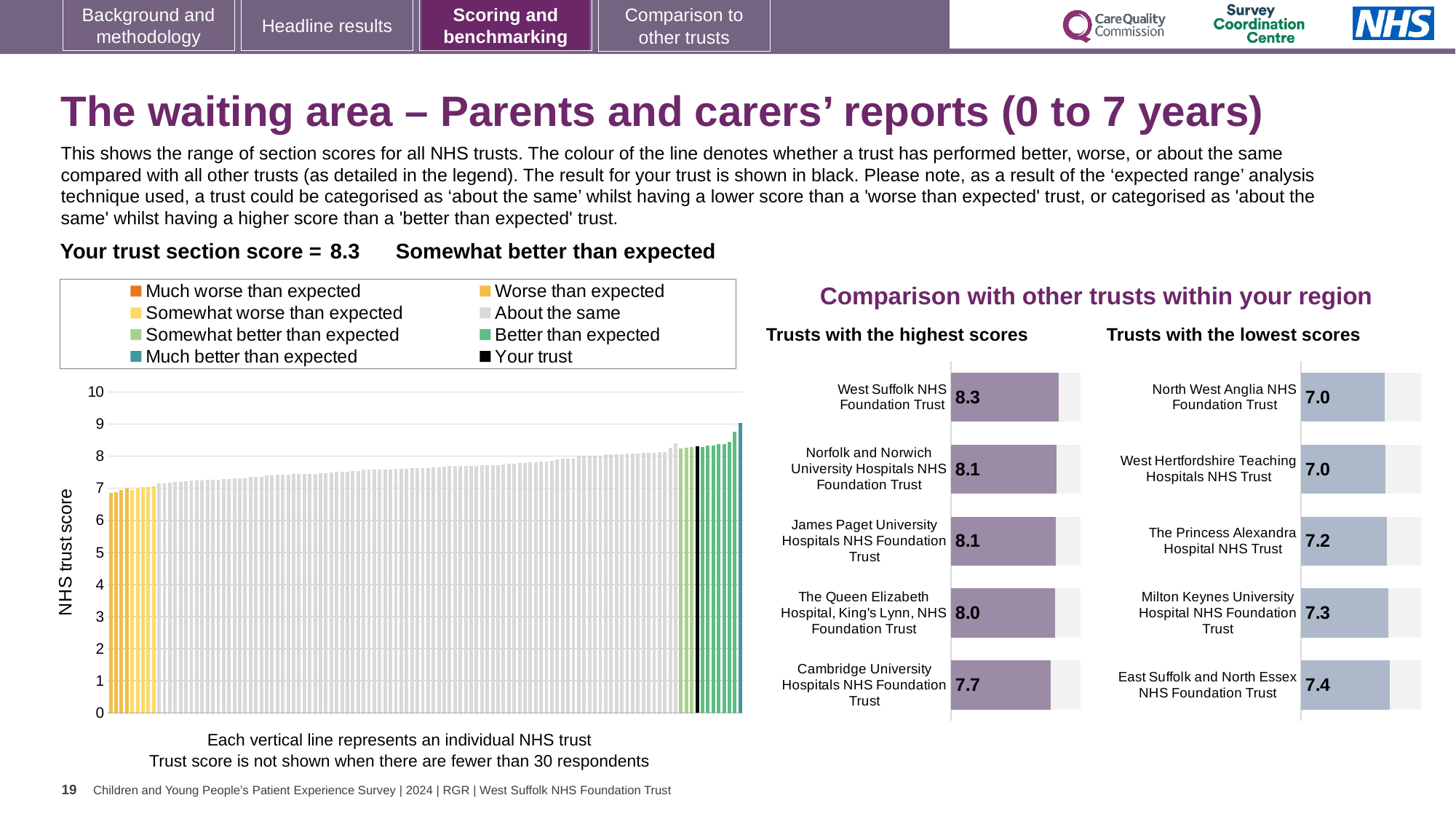
In the large 'NHS trust score' chart on the left, is the value for the black 'Your trust' bar greater or less than 8? greater In the 'Trusts with the highest scores' chart, what is the difference between the scores of West Suffolk NHS Foundation Trust and Cambridge University Hospitals NHS Foundation Trust? 0.6 In the 'Trusts with the highest scores' chart, which trust has the lowest score? Cambridge University Hospitals NHS Foundation Trust In the large 'NHS trust score' chart on the left, do the bar values rise or fall from left to right? rise In the 'Trusts with the lowest scores' chart, which trust has the highest score? East Suffolk and North Essex NHS Foundation Trust In the 'Trusts with the highest scores' chart, what is the score for West Suffolk NHS Foundation Trust? 8.3 In the 'Trusts with the lowest scores' chart, which has the higher score: Milton Keynes University Hospital NHS Foundation Trust or The Princess Alexandra Hospital NHS Trust? Milton Keynes University Hospital NHS Foundation Trust In the 'Trusts with the lowest scores' chart, what is the difference between the scores of East Suffolk and North Essex NHS Foundation Trust and North West Anglia NHS Foundation Trust? 0.4 How many entries does the legend of the large 'NHS trust score' chart on the left list? 8 In the 'Trusts with the highest scores' chart, what is the score for Cambridge University Hospitals NHS Foundation Trust? 7.7 How many trusts are shown in the 'Trusts with the highest scores' chart? 5 In the 'Trusts with the lowest scores' chart, what is the score for The Princess Alexandra Hospital NHS Trust? 7.2